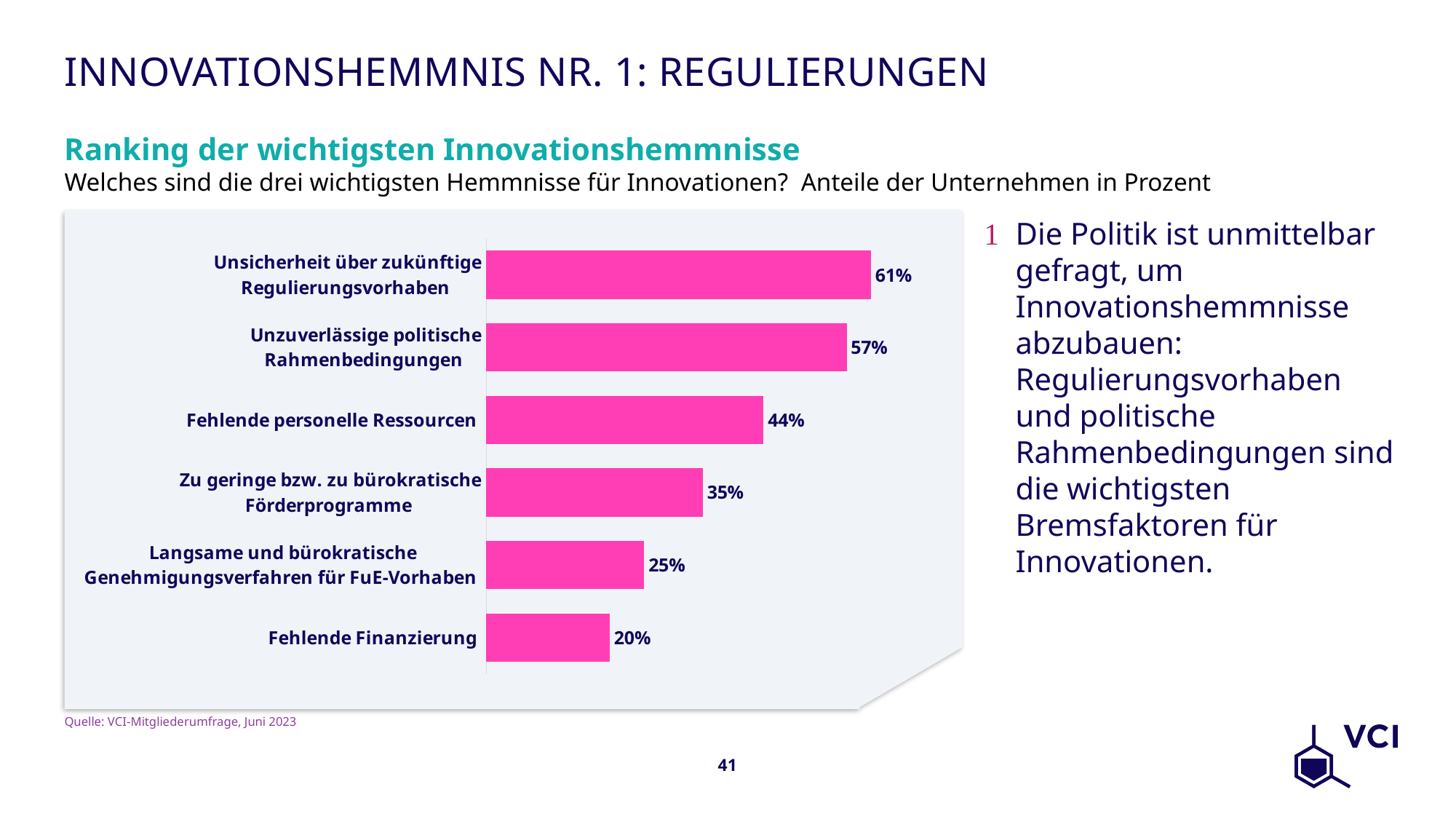
What colour are the bars in the chart? Pink Which is larger: the value for "Fehlende personelle Ressourcen" or the value for "Langsame und bürokratische Genehmigungsverfahren für FuE-Vorhaben"? Fehlende personelle Ressourcen What percentage of companies named "Unsicherheit über zukünftige Regulierungsvorhaben" as an innovation obstacle? 61% How many categories are shown in the chart? 6 What kind of chart is shown on the slide? Bar chart What is the title of the chart? Ranking der wichtigsten Innovationshemmnisse What is the difference between the values for "Unsicherheit über zukünftige Regulierungsvorhaben" and "Unzuverlässige politische Rahmenbedingungen"? 4 percentage points What is the value shown for "Fehlende personelle Ressourcen"? 44% What is the value shown for "Fehlende Finanzierung"? 20% Which category has the lowest value in the chart? Fehlende Finanzierung What is the difference between the values for "Zu geringe bzw. zu bürokratische Förderprogramme" and "Fehlende Finanzierung"? 15 percentage points Which category has the highest value in the chart? Unsicherheit über zukünftige Regulierungsvorhaben